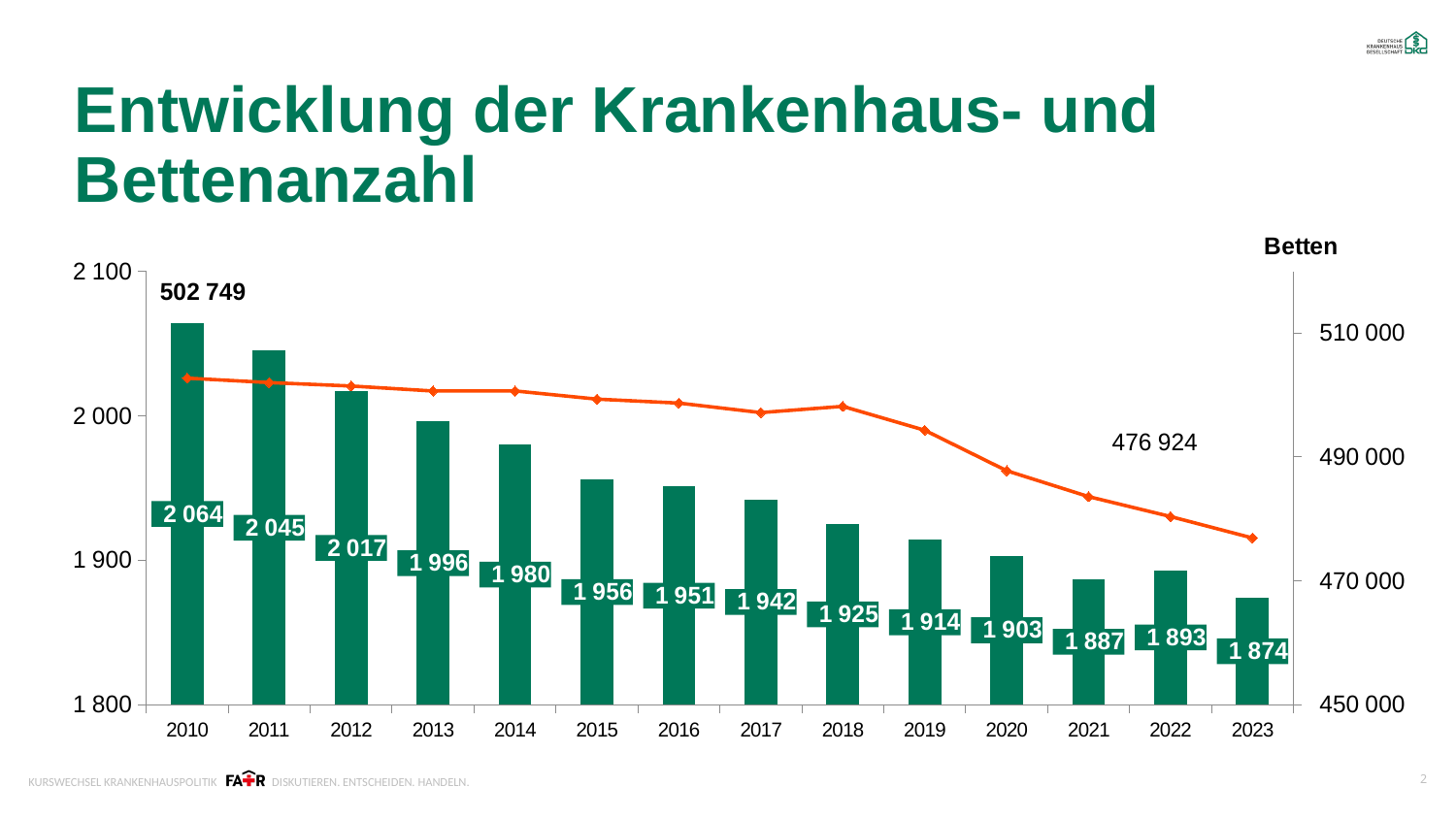
What is the difference between the bar values for 2012 and 2013? 21 What label is shown above the right-hand axis? Betten What is the difference between the bar values for 2010 and 2023? 190 What is the value of the bar for 2015? 1 956 Is the value of the line for 2019 greater or less than 490 000? greater Do the bar values rise or fall from 2010 to 2023? fall What is the value of the bar for 2023? 1 874 Which year has the lowest bar? 2023 How many years are shown on the x axis? 14 Which bar is larger, 2021 or 2022? 2022 Which year has the highest bar? 2010 What is the value of the bar for 2010? 2 064